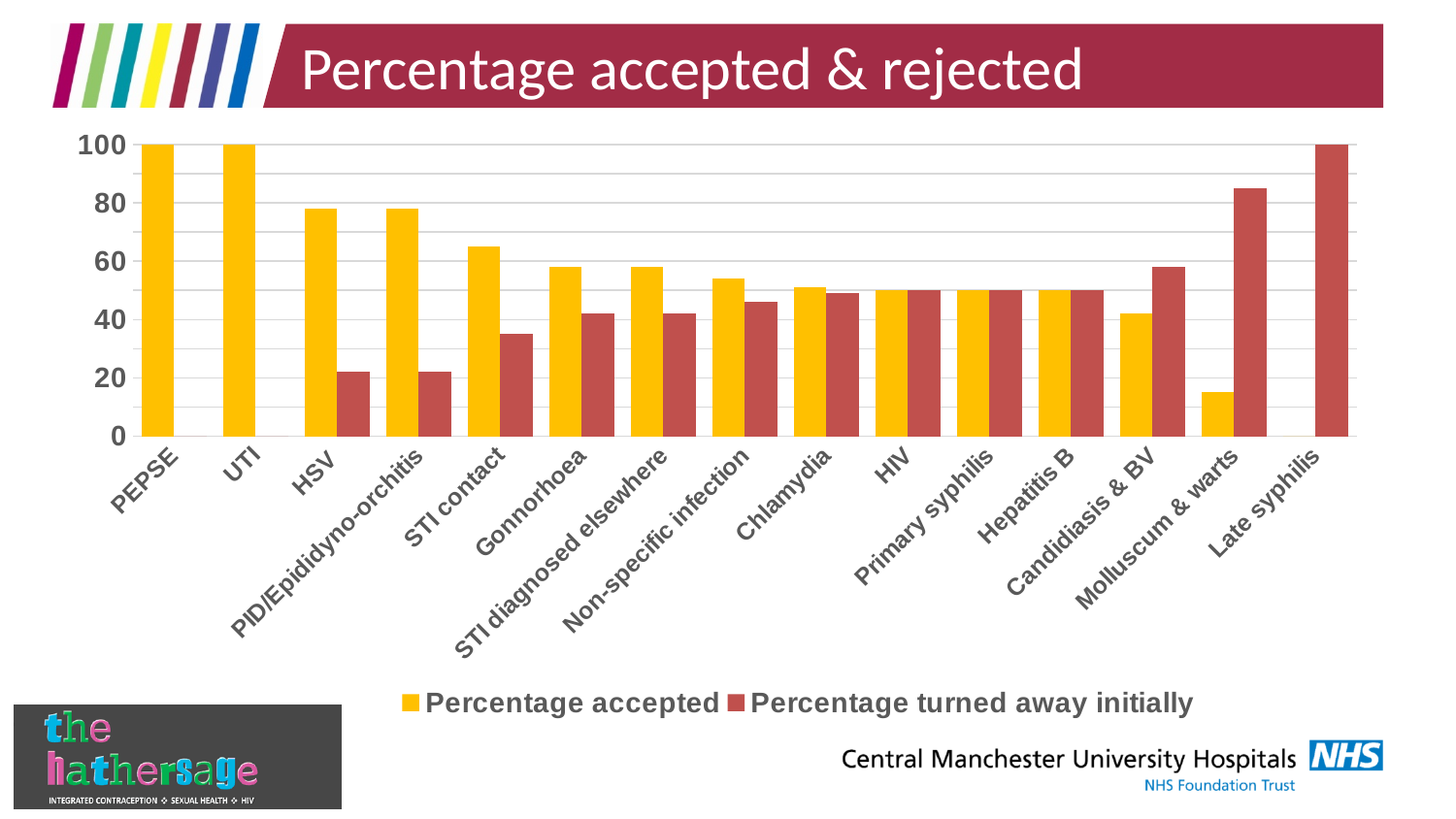
Which category has the highest percentage turned away initially? Late syphilis What is the percentage accepted for UTI? 100 What type of chart is shown on the slide? Bar chart For Molluscum & warts, which is larger: the percentage accepted or the percentage turned away initially? Percentage turned away initially What is the percentage accepted for PEPSE? 100 What is the percentage turned away initially for Late syphilis? 100 Do the percentage accepted values generally rise or fall from left to right along the x axis? Fall Is the percentage accepted for Molluscum & warts greater or less than 20? less How many series does the legend list? 2 Is the percentage turned away initially for STI contact greater or less than 40? less How many categories are shown on the x axis? 15 Is the percentage accepted for HSV greater or less than 60? greater